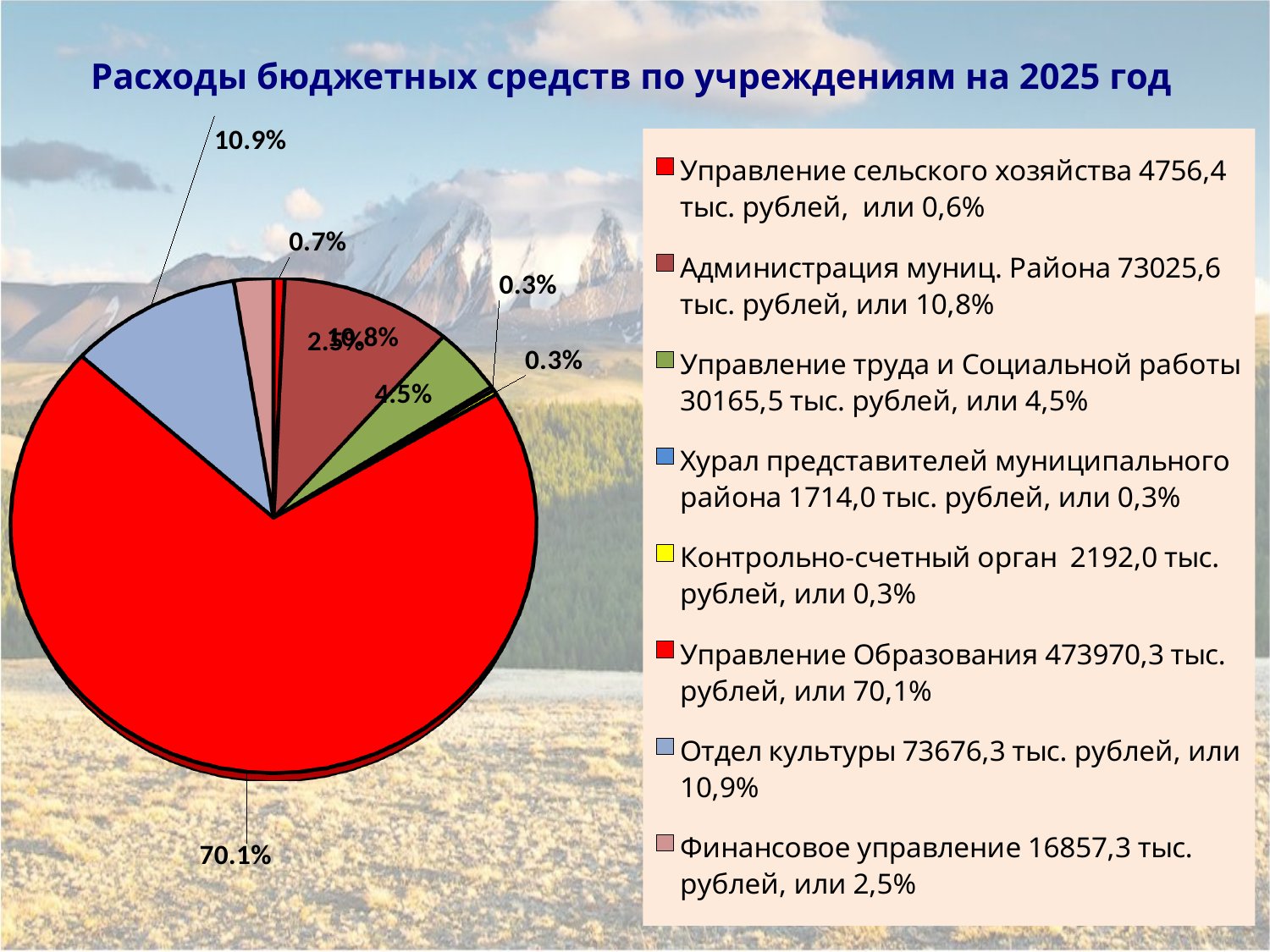
What share of the pie does Управление Образования account for? 70.1% How many entries does the legend of the pie chart list? 8 According to the legend, what share does Администрация муниц. Района have? 10,8% What share of the pie does Отдел культуры account for? 10.9% According to the legend, what is the amount for Отдел культуры? 73676,3 тыс. рублей What is the title of the chart on the slide? Расходы бюджетных средств по учреждениям на 2025 год Which institution has the largest slice of the pie chart? Управление Образования Which slice is larger: Управление труда и Социальной работы or Финансовое управление? Управление труда и Социальной работы What kind of chart is shown on the slide? pie chart What is the difference in percentage points between the share of Управление Образования (70.1%) and Отдел культуры (10.9%)? 59.2% According to the legend, what is the amount for Управление Образования? 473970,3 тыс. рублей